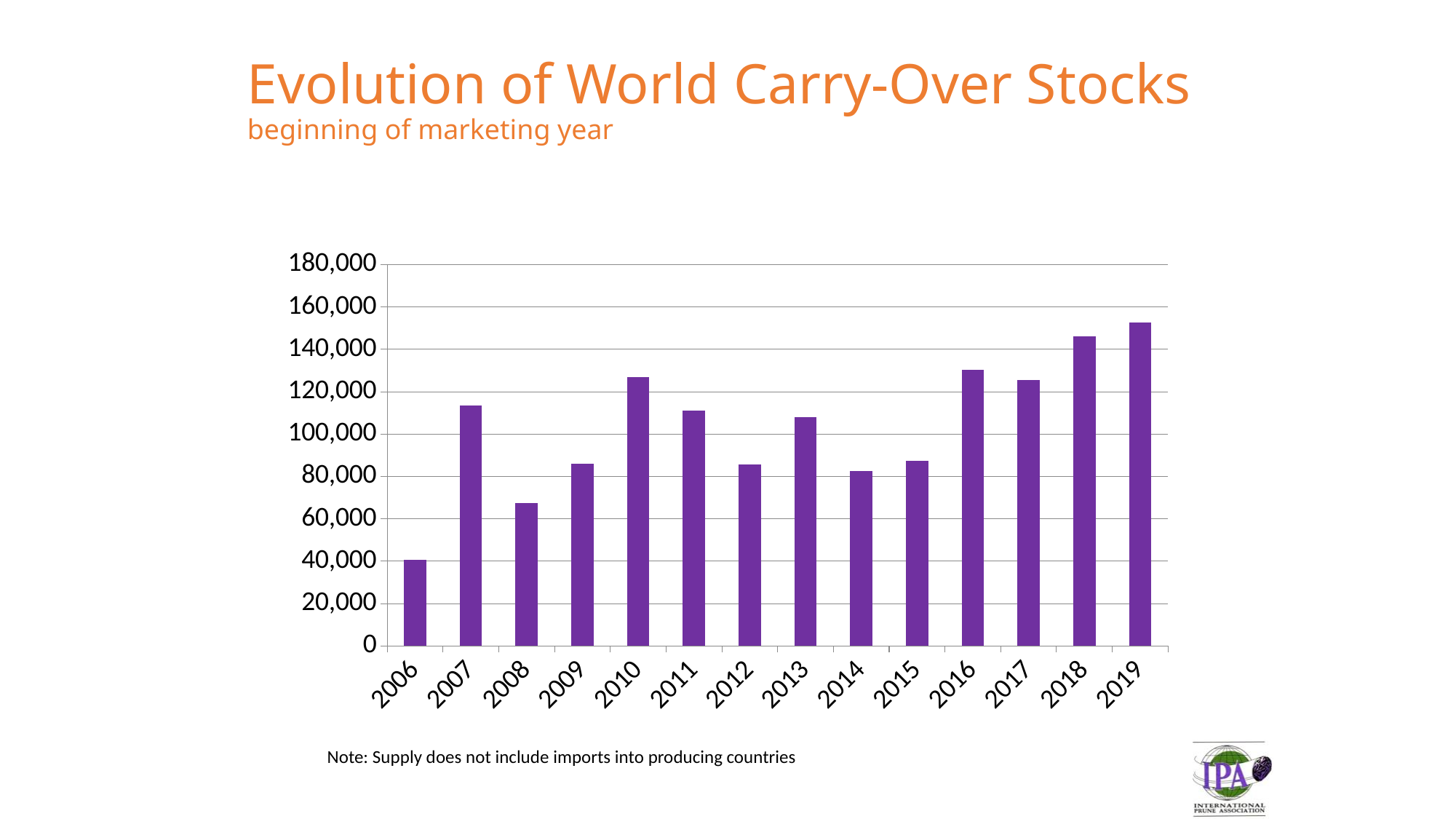
Which year has the lowest carry-over stocks? 2006 Which year has the larger value, 2007 or 2008? 2007 Which year has the larger value, 2010 or 2011? 2010 What is the title of the chart on the slide? Evolution of World Carry-Over Stocks Is the value for 2006 greater or less than 60,000? less Is the value for 2010 greater or less than 120,000? greater Do the values rise or fall from 2010 to 2012? fall Is the value for 2014 greater or less than 100,000? less Which year has the highest carry-over stocks? 2019 What kind of chart is shown on the slide? bar chart How many years are plotted on the x axis? 14